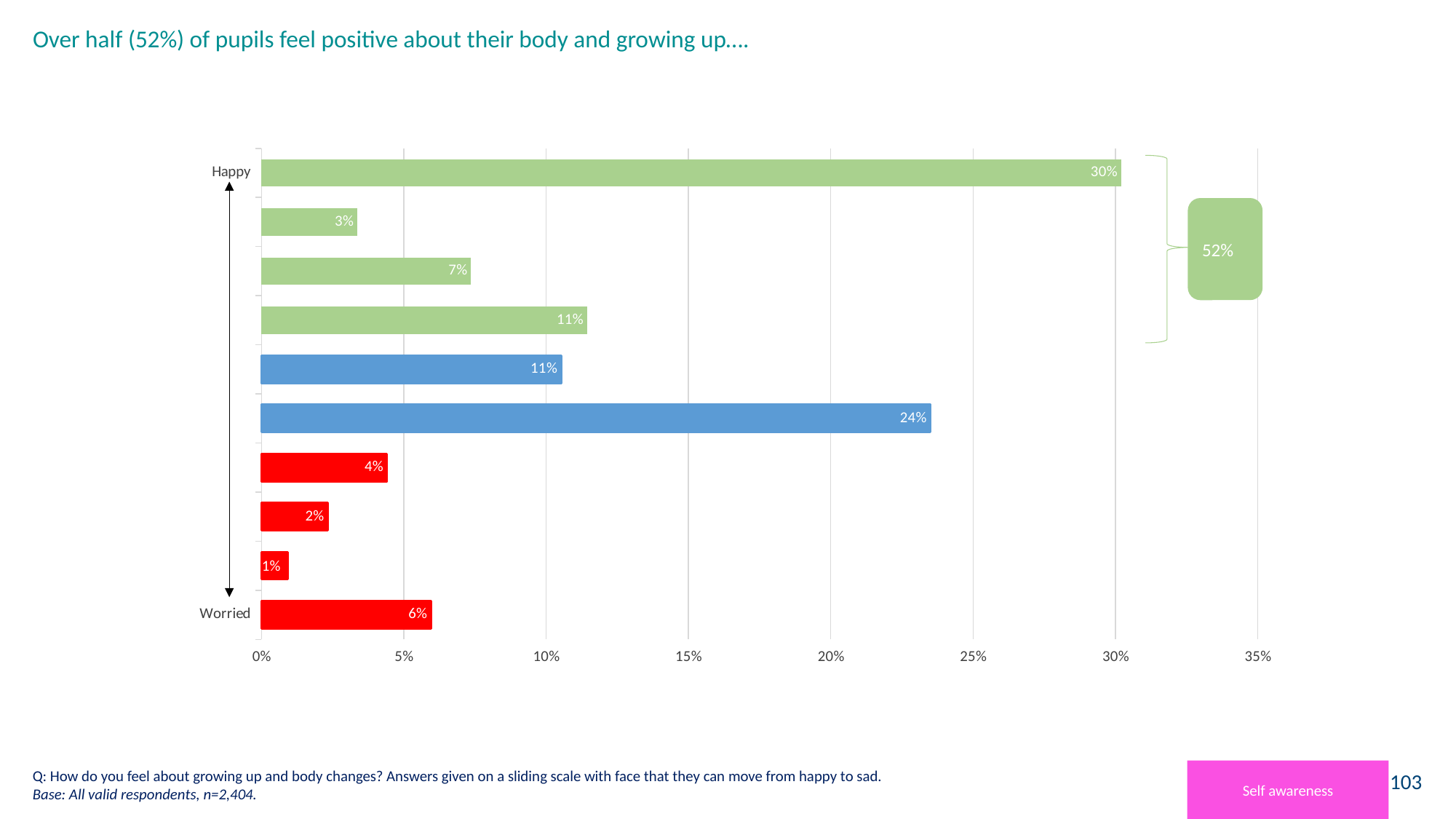
What is the value of the bar labelled Happy? 30% What is the difference between the Happy bar and the Worried bar? 24% Which labelled category has the highest value, Happy or Worried? Happy Is the value for Happy greater or less than 25%? greater What is the smallest value shown on any bar in the chart? 1% What is the value of the bar labelled Worried? 6% Which is larger, the value for Happy or the value for Worried? Happy How many bars are plotted in the chart? 10 What colour is the bar labelled Happy? green How many bars in the chart are coloured red? 4 What percentage is shown in the green callout box to the right of the chart? 52% What kind of chart is shown on the slide? bar chart